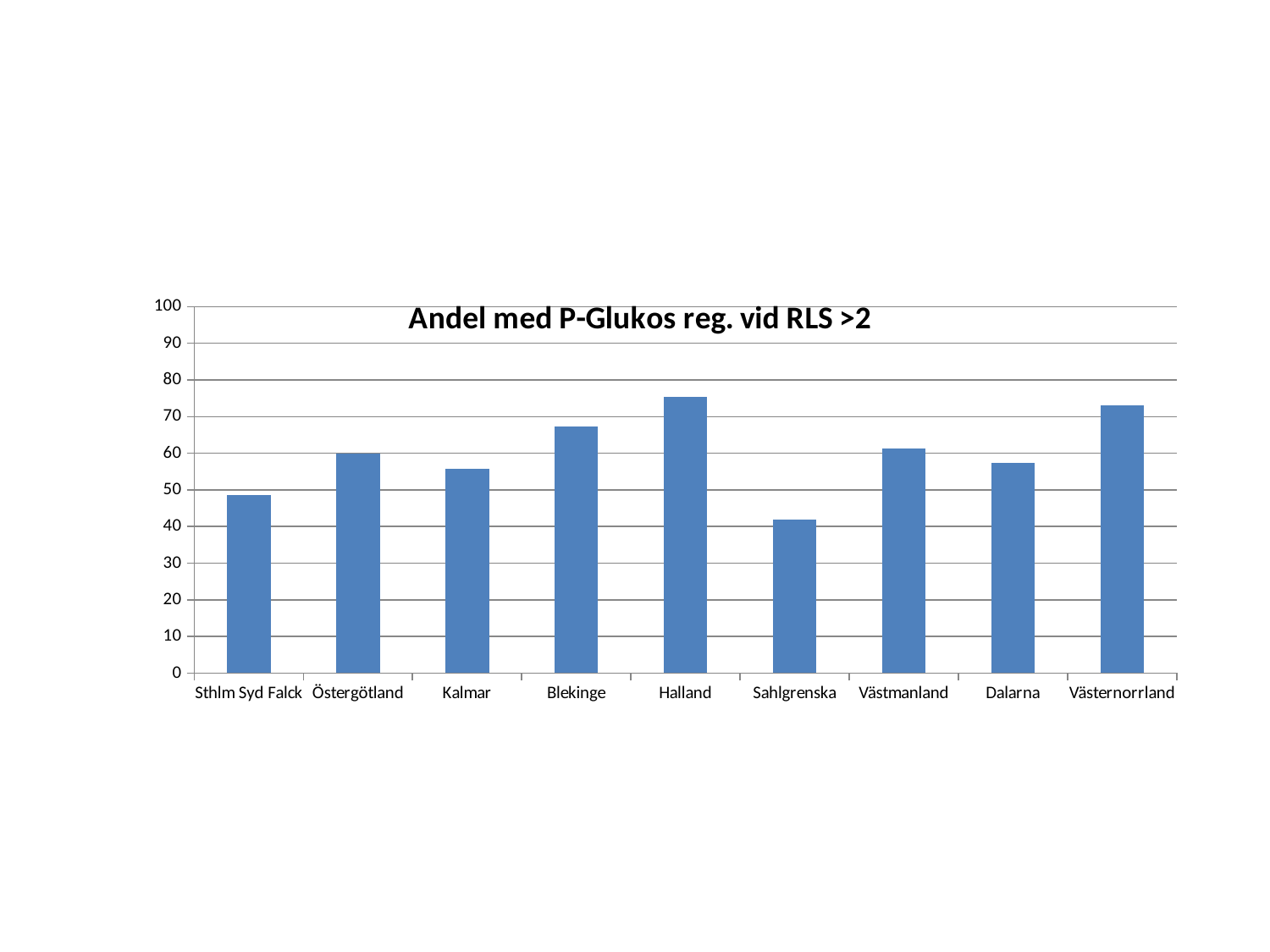
Is the value for Blekinge greater or less than 60? greater Which category has the lowest bar in the chart? Sahlgrenska Is the value for Halland greater or less than 70? greater Is the value for Västernorrland greater or less than 70? greater What is the title of the chart? Andel med P-Glukos reg. vid RLS >2 How many categories are shown on the x axis of the chart? 9 Which category has the highest bar in the chart? Halland Which has the larger value, Östergötland or Sthlm Syd Falck? Östergötland Which has the larger value, Blekinge or Kalmar? Blekinge What type of chart is shown on the slide? bar chart